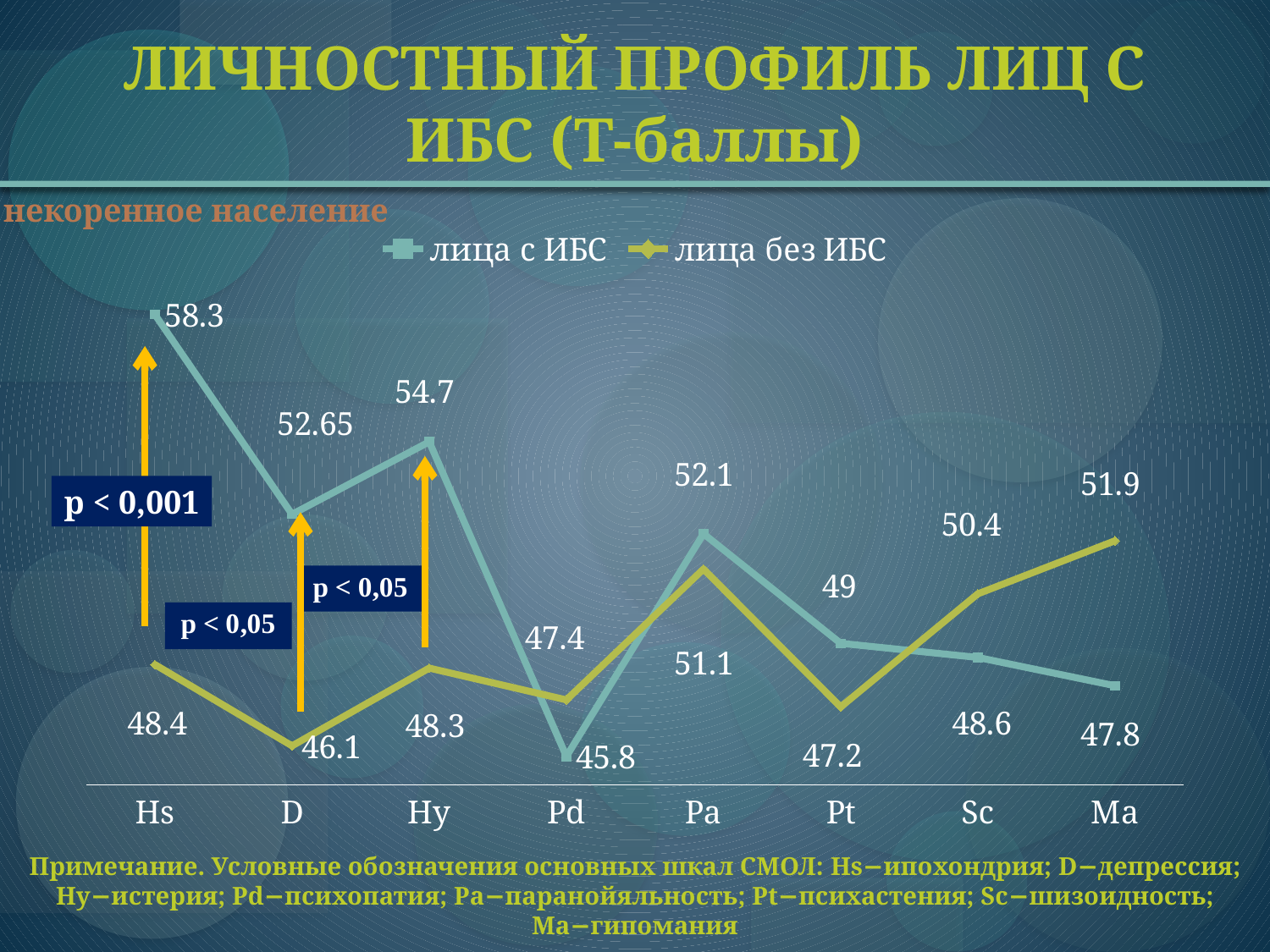
How many categories are shown on the x axis? 8 How many series does the legend list? 2 What is the difference between лица с ИБС and лица без ИБС at Hs? 9.9 What is the value for лица с ИБС at Pt? 49 At Sc, which series has the larger value, лица с ИБС or лица без ИБС? лица без ИБС For which category is the value for лица с ИБС lowest? Pd What kind of chart is shown on the slide? line chart What is the value for лица с ИБС at Hs? 58.3 What is the value for лица без ИБС at Ma? 51.9 For which category is the value for лица с ИБС highest? Hs For which category is the value for лица без ИБС lowest? D What are the two series named in the legend? лица с ИБС and лица без ИБС